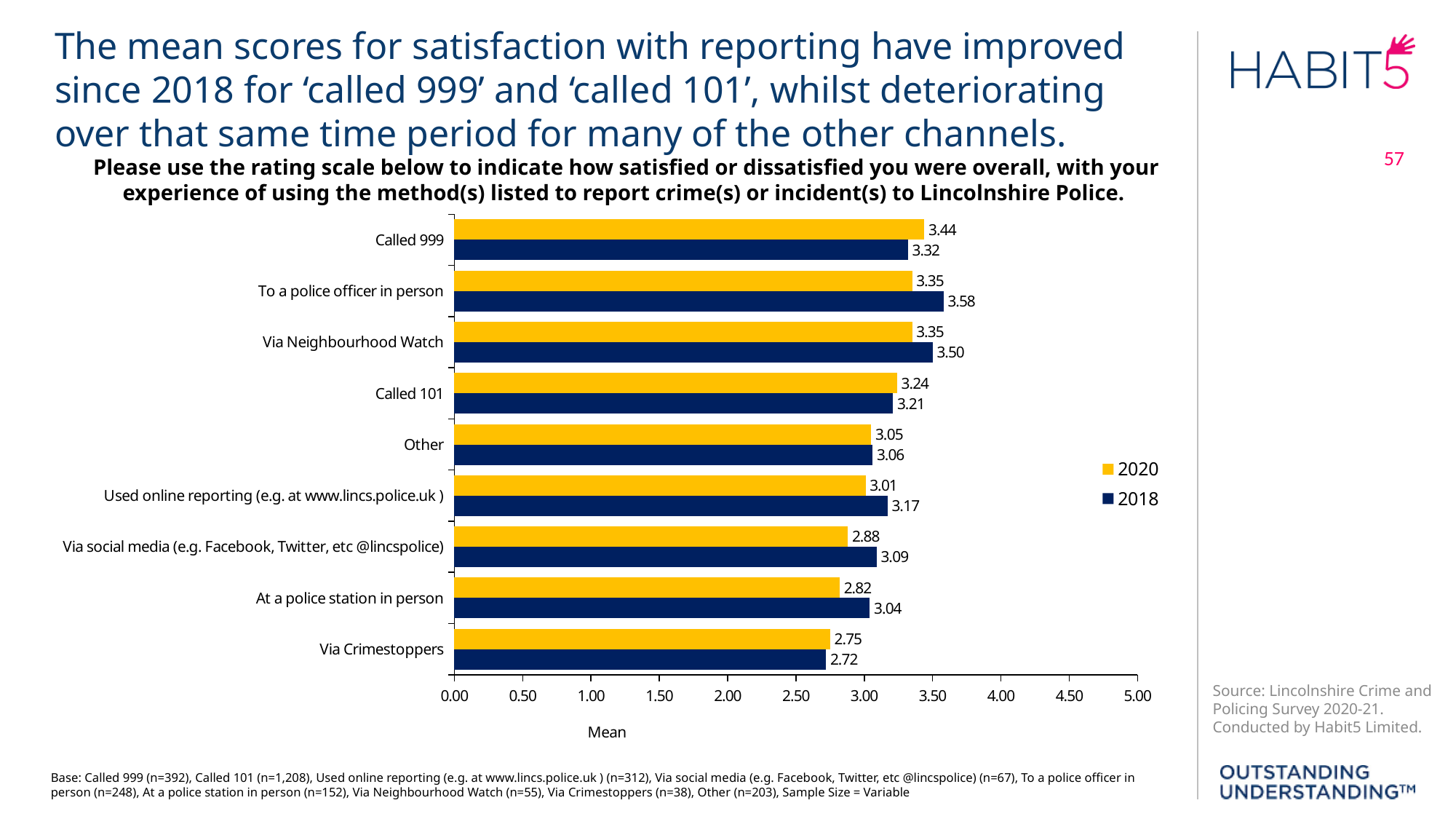
How many series does the legend list? 2 How many reporting methods are shown on the chart? 9 Which reporting method has the highest 2020 mean score? Called 999 Which reporting method has the lowest 2018 mean score? Via Crimestoppers What is the difference between the 2018 and 2020 mean scores for 'To a police officer in person'? 0.23 Which colour represents the 2020 series in the chart? Yellow What type of chart is shown on the slide? Bar chart What is the 2020 mean score for 'Via Crimestoppers'? 2.75 What is the 2020 mean satisfaction score for 'Called 999'? 3.44 Which is larger for 'Used online reporting (e.g. at www.lincs.police.uk )': the 2020 score or the 2018 score? 2018 Is the 2020 mean score for 'At a police station in person' greater or less than 3.00? less What is the 2018 mean satisfaction score for 'To a police officer in person'? 3.58